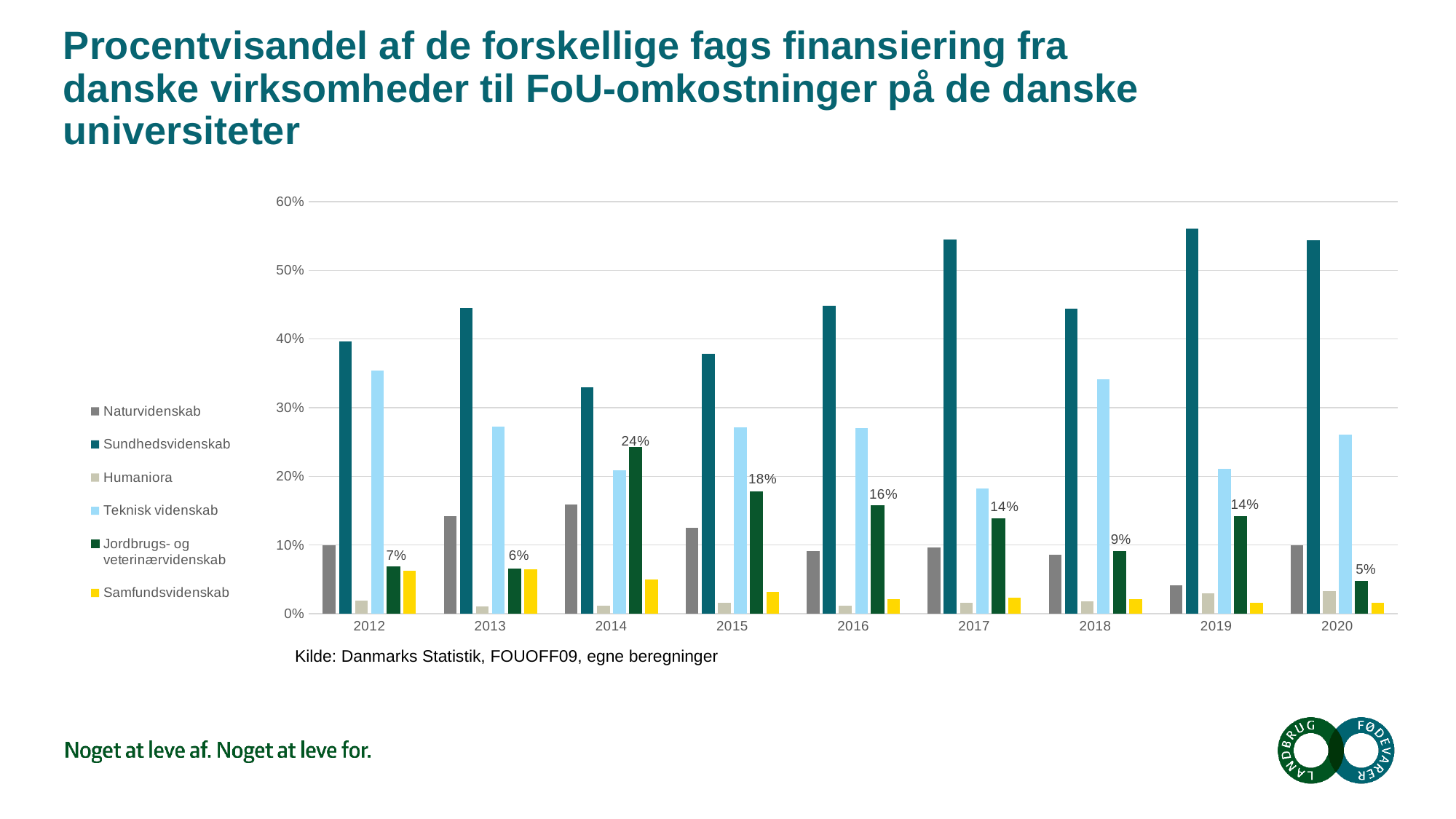
How many series does the legend list? 6 What is the value for Jordbrugs- og veterinærvidenskab in 2014? 24% What is the value for Jordbrugs- og veterinærvidenskab in 2012? 7% How many years are shown on the x axis? 9 What is the difference between the Jordbrugs- og veterinærvidenskab values for 2014 and 2015? 6 percentage points Is the value for Sundhedsvidenskab in 2019 greater or less than 50%? greater In which year is the value for Jordbrugs- og veterinærvidenskab lowest? 2020 What kind of chart is shown on the slide? Bar chart What is the value for Jordbrugs- og veterinærvidenskab in 2020? 5% In which year is the value for Jordbrugs- og veterinærvidenskab highest? 2014 Which year has the larger value for Jordbrugs- og veterinærvidenskab, 2016 or 2017? 2016 Is the value for Naturvidenskab in 2014 greater or less than 20%? less